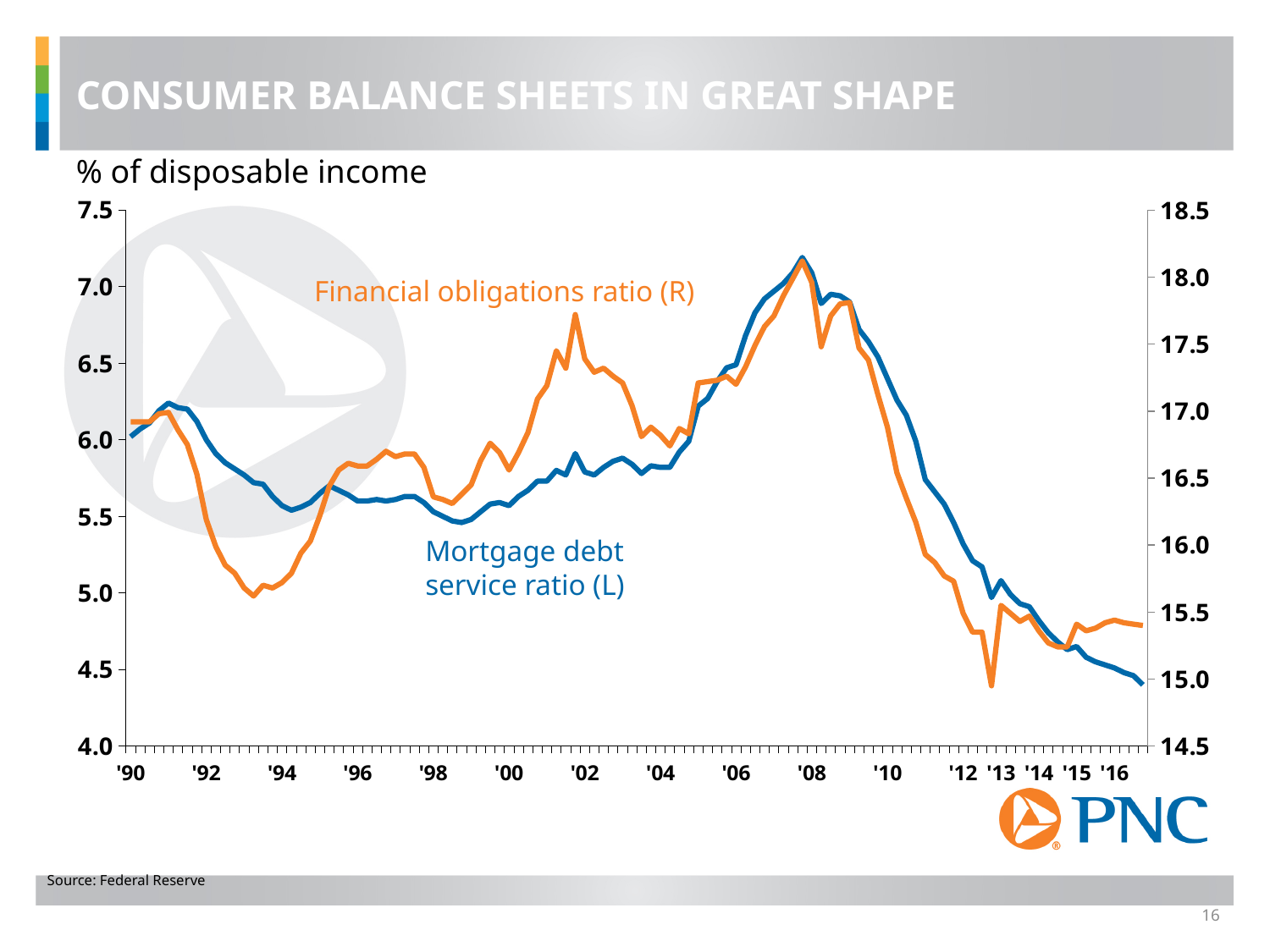
Is the Mortgage debt service ratio larger in '08 or in '16? '08 Around which year does the Mortgage debt service ratio reach its highest value? '08 What kind of chart is shown on the slide? line chart Is the Mortgage debt service ratio in '16 greater or less than 5.0? less What is the title of the slide containing the chart? CONSUMER BALANCE SHEETS IN GREAT SHAPE Which series is plotted against the right-hand axis? Financial obligations ratio Is the Financial obligations ratio in '16 greater or less than 16.0? less Is the Mortgage debt service ratio at its '08 peak greater or less than 7.0? greater Do both series rise or fall between '08 and '16? fall How many data series are plotted on the chart? 2